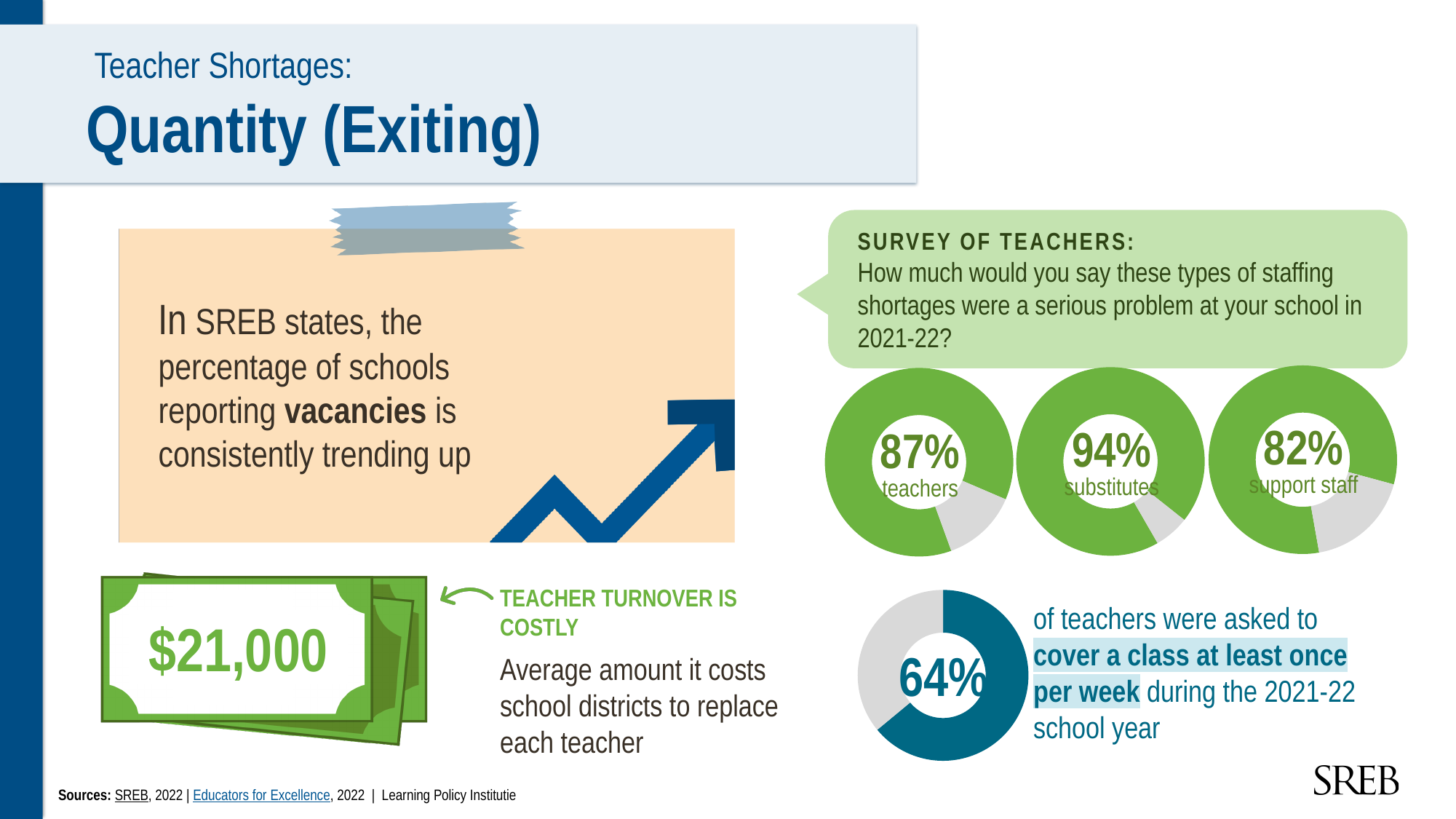
In the blue donut chart at the bottom right, what percentage of teachers were asked to cover a class at least once per week during the 2021-22 school year? 64% In the survey of teachers donut charts, is the percentage for teachers or for support staff larger? teachers Among the three green donut charts (teachers, substitutes, support staff), which staffing type has the lowest percentage? support staff What colour is the filled portion of the donut chart showing 64%? blue In the survey of teachers donut charts, what is the difference between the substitutes percentage and the support staff percentage? 12% In the survey of teachers donut charts, what is the difference between the teachers percentage and the substitutes percentage? 7% In the survey of teachers donut charts, what percentage is shown for support staff? 82% In the survey of teachers donut charts, what percentage is shown for substitutes? 94% Among the three green donut charts (teachers, substitutes, support staff), which staffing type has the highest percentage? substitutes What type of chart is used to show the 64% figure at the bottom right of the slide? donut chart In the survey of teachers donut charts, what percentage of teachers said teacher shortages were a serious problem at their school in 2021-22? 87% How many green donut charts are shown under the survey of teachers question? 3